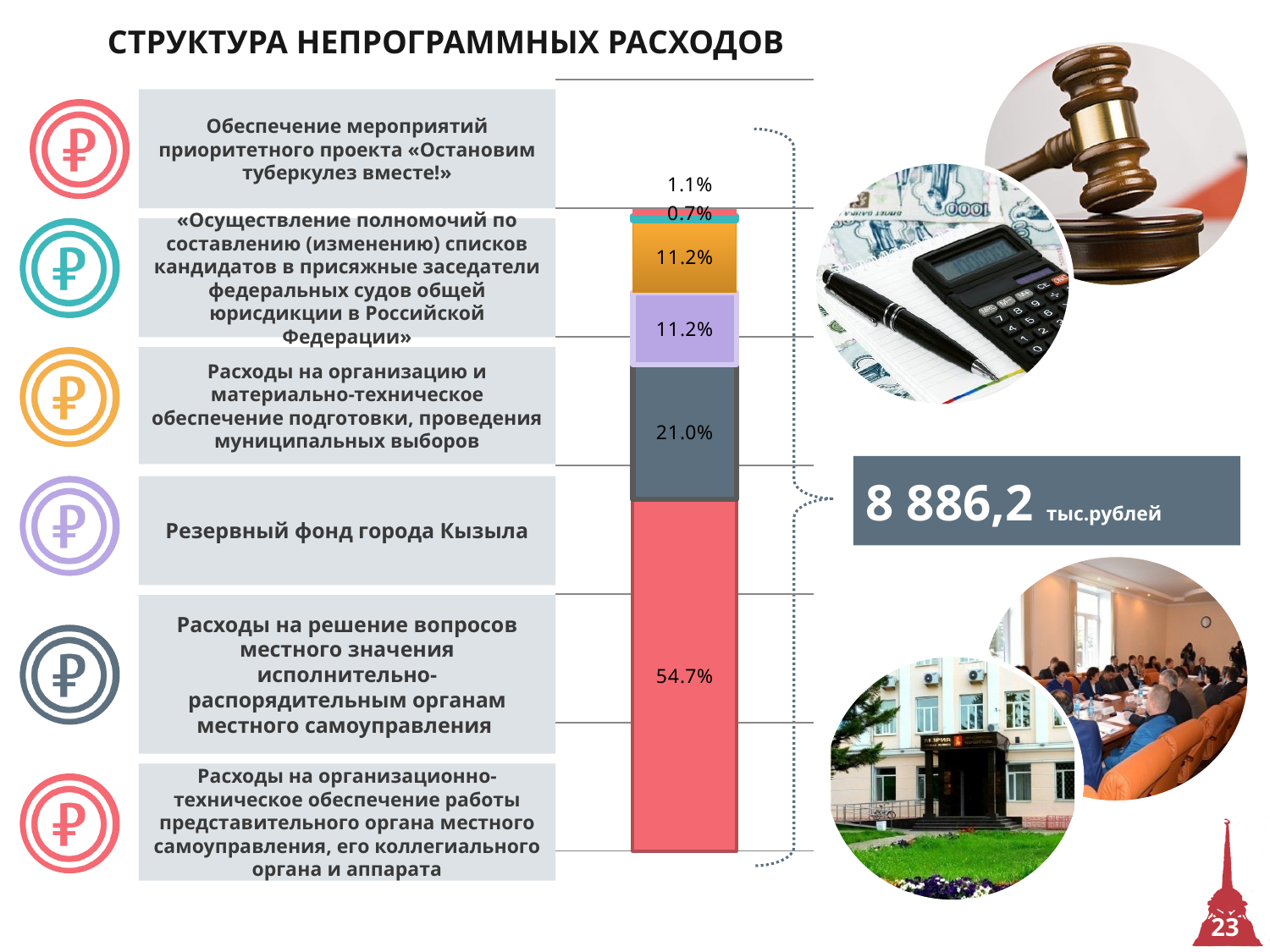
What kind of chart is shown on the slide? Stacked bar chart What percentage is shown on the dark grey segment of the bar? 21.0% How many segments does the stacked bar contain? 6 What percentage is shown on the thin teal segment of the bar? 0.7% What is the difference in percentage points between the largest segment (54.7%) and the dark grey segment (21.0%)? 33.7 Which segment is larger, the dark grey one or the purple one? The dark grey one (21.0%) What is the difference in percentage points between the dark grey segment (21.0%) and the purple segment (11.2%)? 9.8 What is the smallest percentage shown on the stacked bar? 0.7% What percentage is shown on the large red segment at the bottom of the bar? 54.7% What total amount is shown in the box next to the stacked bar? 8 886,2 тыс.рублей What is the largest percentage shown on the stacked bar? 54.7% What percentage is shown on the orange segment of the bar? 11.2%